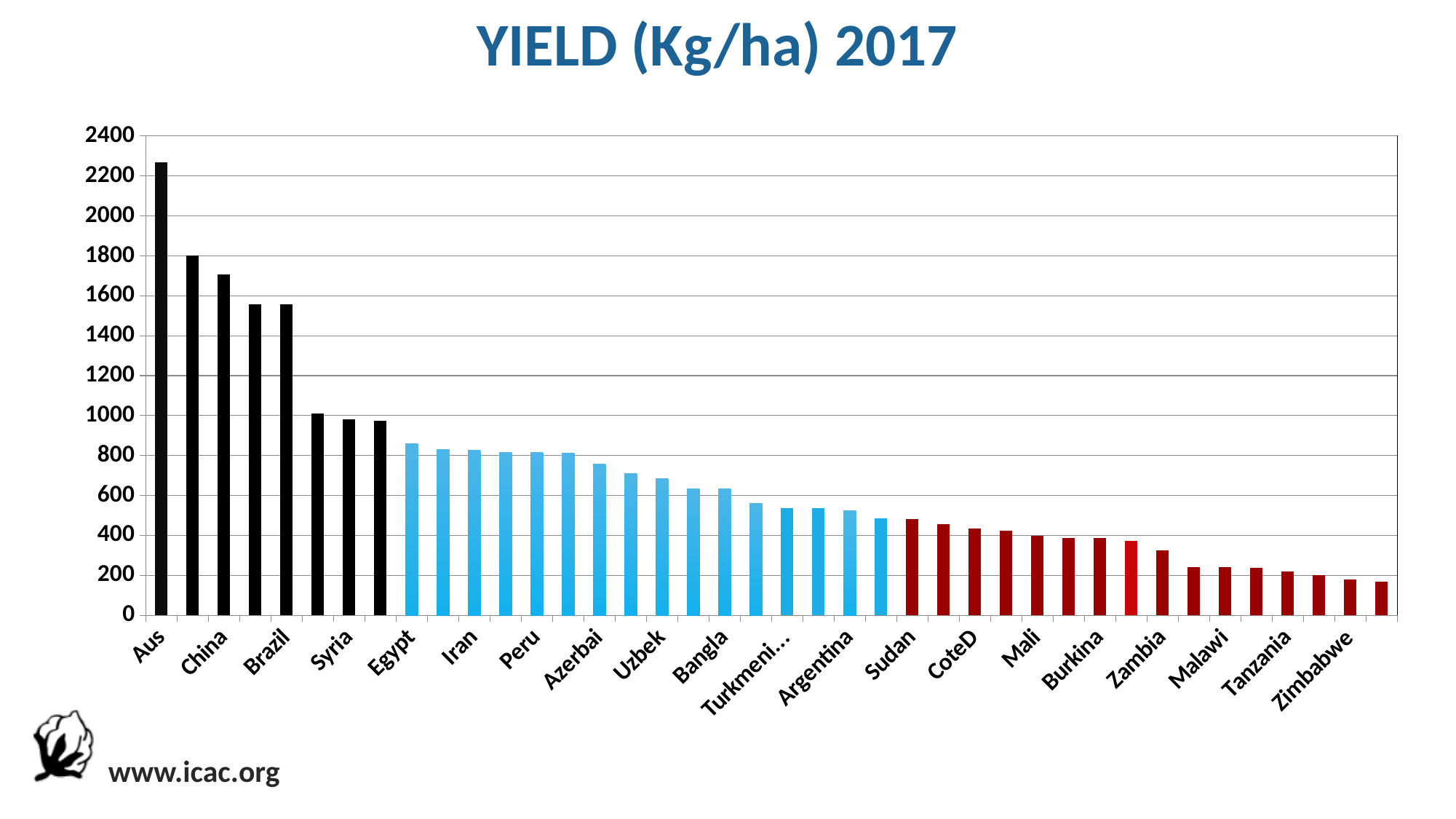
Is the value for China greater or less than 1600? greater Is the value for Sudan greater or less than 600? less Is the value for Egypt greater or less than 800? greater What kind of chart is shown on the slide? bar chart What is the title of the chart? YIELD (Kg/ha) 2017 Which country has the highest yield in the chart? Aus How many different bar colours are used in the chart? 3 Which has the larger yield, Aus or China? Aus Do the values rise or fall moving from left to right along the x axis? fall